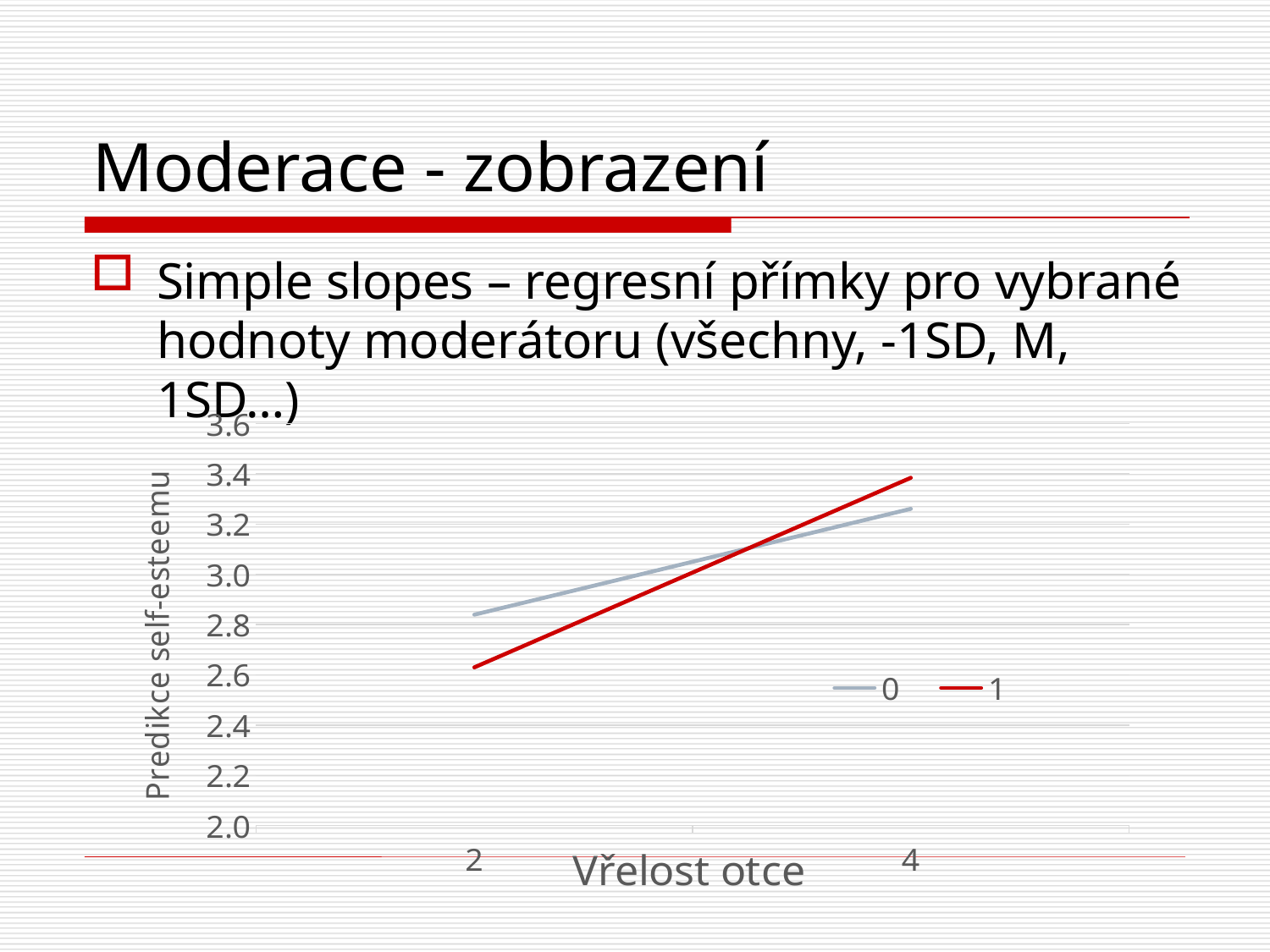
What are the names of the series in the chart legend? 0 and 1 At Vřelost otce = 4, which series has the higher predicted self-esteem, 0 or 1? 1 At Vřelost otce = 2, which series has the higher predicted self-esteem, 0 or 1? 0 Is the value for series 0 at Vřelost otce = 2 greater or less than 3.0? less What is the title of the x axis of the chart? Vřelost otce Is the value for series 1 at Vřelost otce = 4 greater or less than 3.2? greater How many series does the chart legend list? 2 Which series has the steeper slope, 0 or 1? 1 Is the value for series 1 at Vřelost otce = 2 greater or less than 2.8? less What kind of chart is shown on the slide? line chart Does the value of series 0 rise or fall as Vřelost otce increases from 2 to 4? rises Does the value of series 1 rise or fall as Vřelost otce increases from 2 to 4? rises